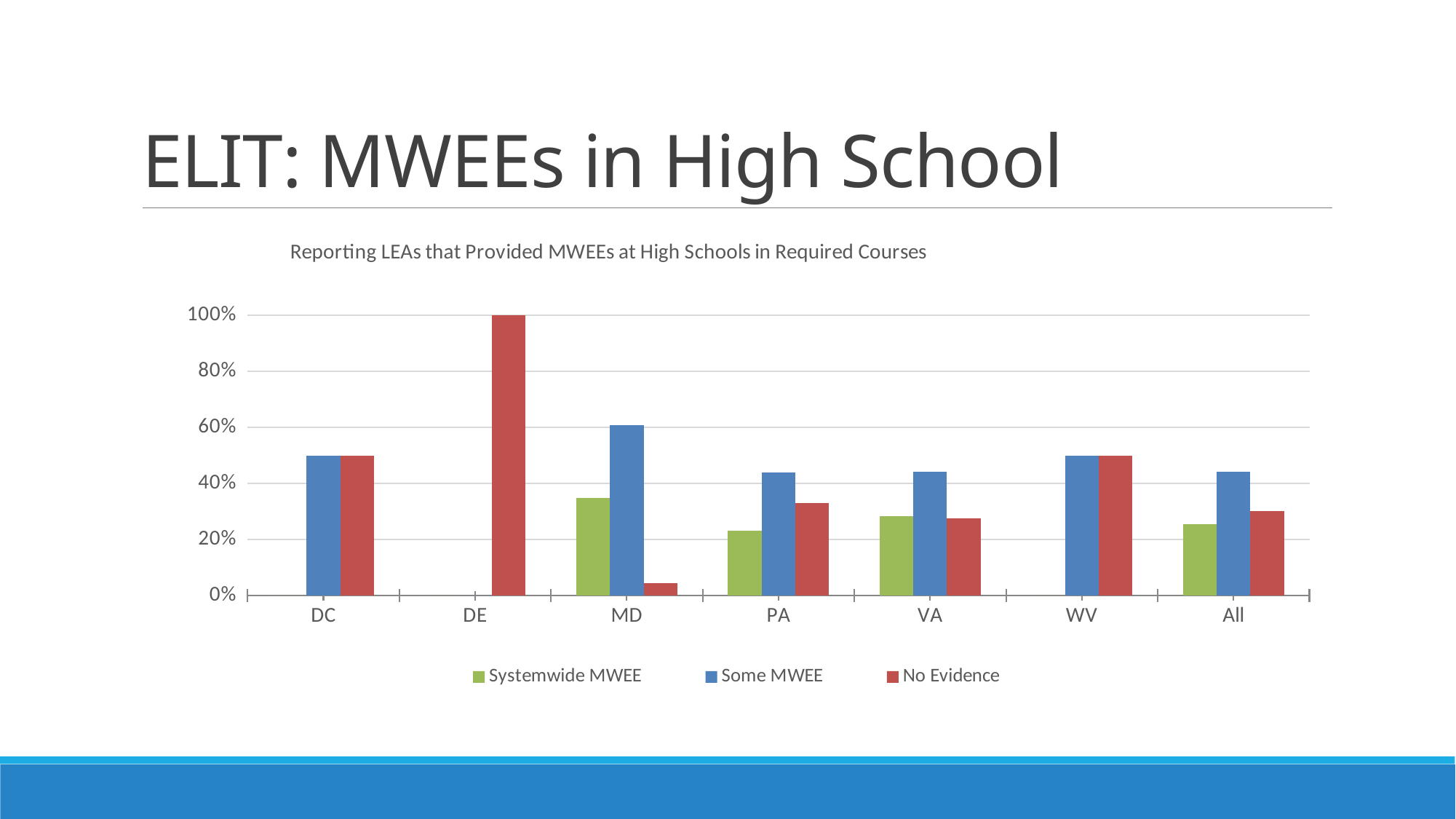
Which category has the lowest No Evidence bar? MD What kind of chart is shown on the slide? bar chart Is the Some MWEE value for MD greater or less than 40%? greater Which is larger, the Systemwide MWEE value for MD or for PA? MD Which category has the highest No Evidence bar? DE How many categories are shown on the x axis? 7 Is the Systemwide MWEE value for PA greater or less than 40%? less What is the title of the chart? Reporting LEAs that Provided MWEEs at High Schools in Required Courses Is the No Evidence value for MD greater or less than 20%? less Which is larger, the Some MWEE value for MD or for VA? MD How many series does the legend list? 3 What is the No Evidence value for DE? 100%